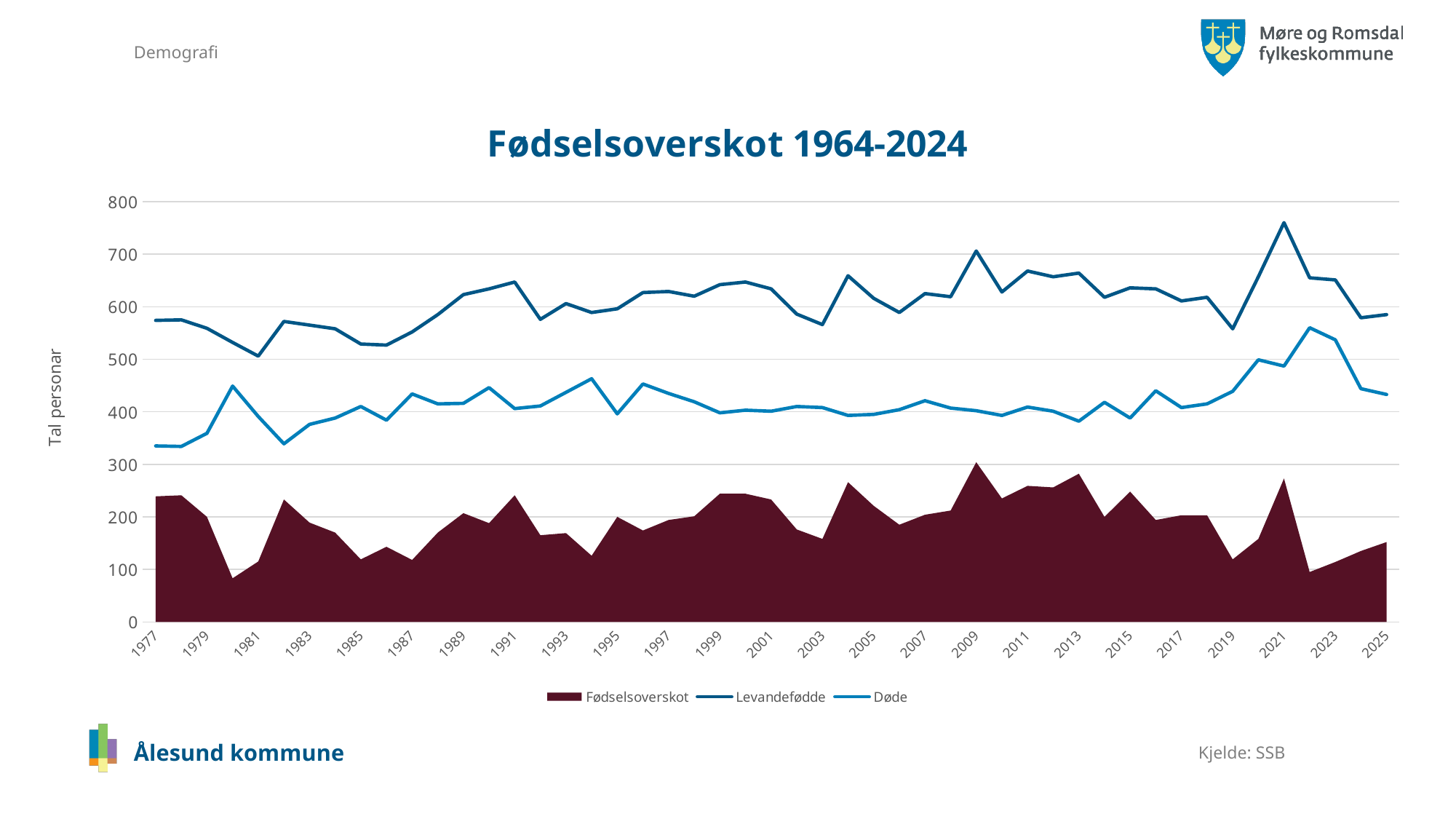
Is the value for Fødselsoverskot in 2023 greater or less than 150? less Does the Levandefødde series rise or fall from 2021 to 2025? fall Is the value for Levandefødde in 2021 greater or less than 700? greater What is the title of the chart? Fødselsoverskot 1964-2024 Is the value for Døde in 1977 greater or less than 400? less In which year does the Fødselsoverskot series reach its highest value? 2009 What is the label on the vertical axis? Tal personar In 2021, which is larger: Levandefødde or Døde? Levandefødde In which year does the Levandefødde series reach its highest value? 2021 How many series does the legend list? 3